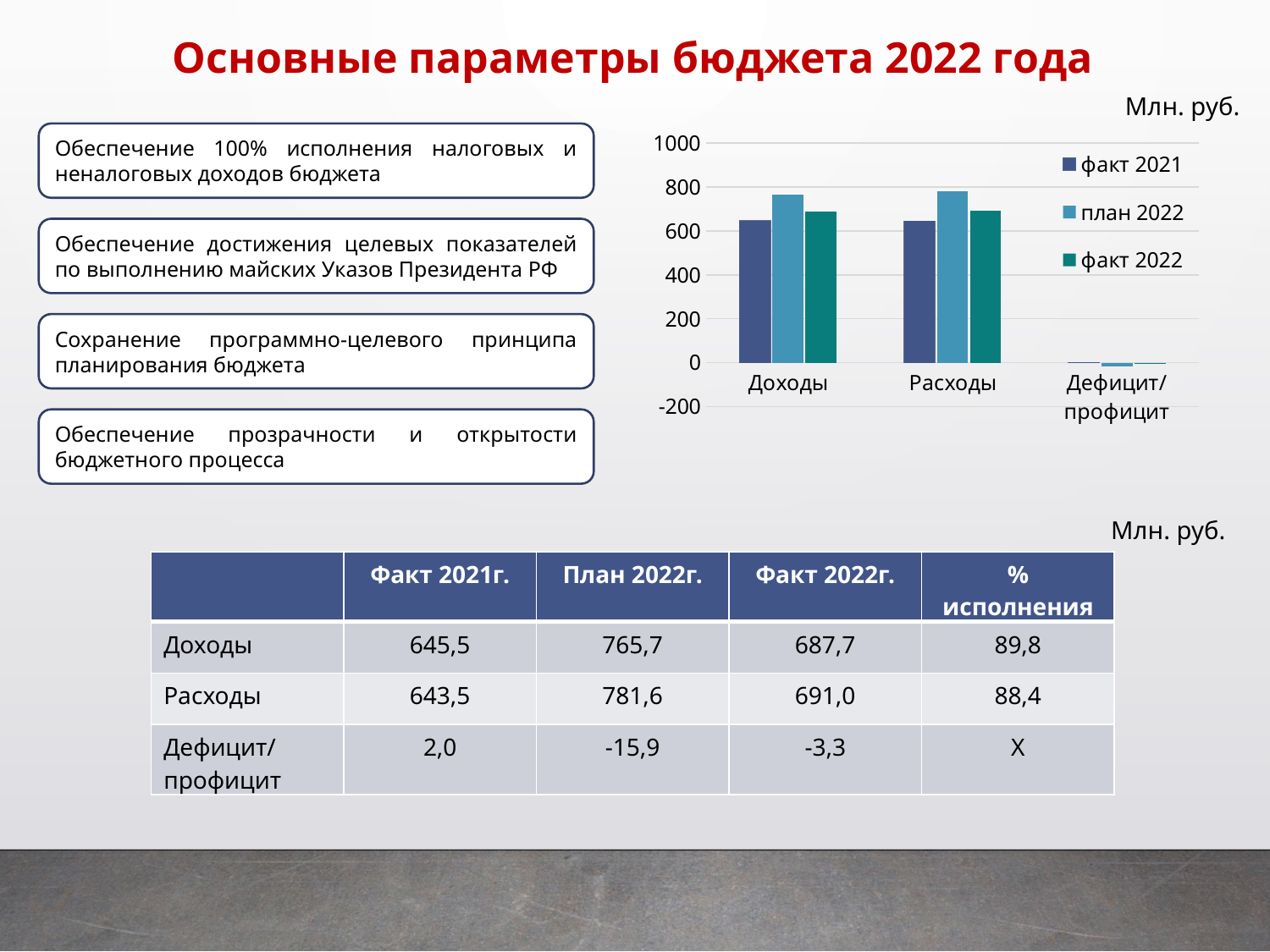
How many categories are shown on the x axis of the chart? 3 In the Расходы category, which series has the shortest bar? факт 2021 What unit is indicated above the chart? Млн. руб. How many series does the chart legend list? 3 What kind of chart is shown on the slide? bar chart In the Доходы category, which series has the tallest bar? план 2022 What is the план 2022 value for Расходы, as printed on the slide? 781,6 Is the value for факт 2021 in the Доходы category greater or less than 800? less Which series does the chart legend list first? факт 2021 Is the value for план 2022 in the Расходы category greater or less than 600? greater Which is larger in the Доходы category: the факт 2022 bar or the факт 2021 bar? факт 2022 What is the факт 2022 value for Доходы, as printed on the slide? 687,7